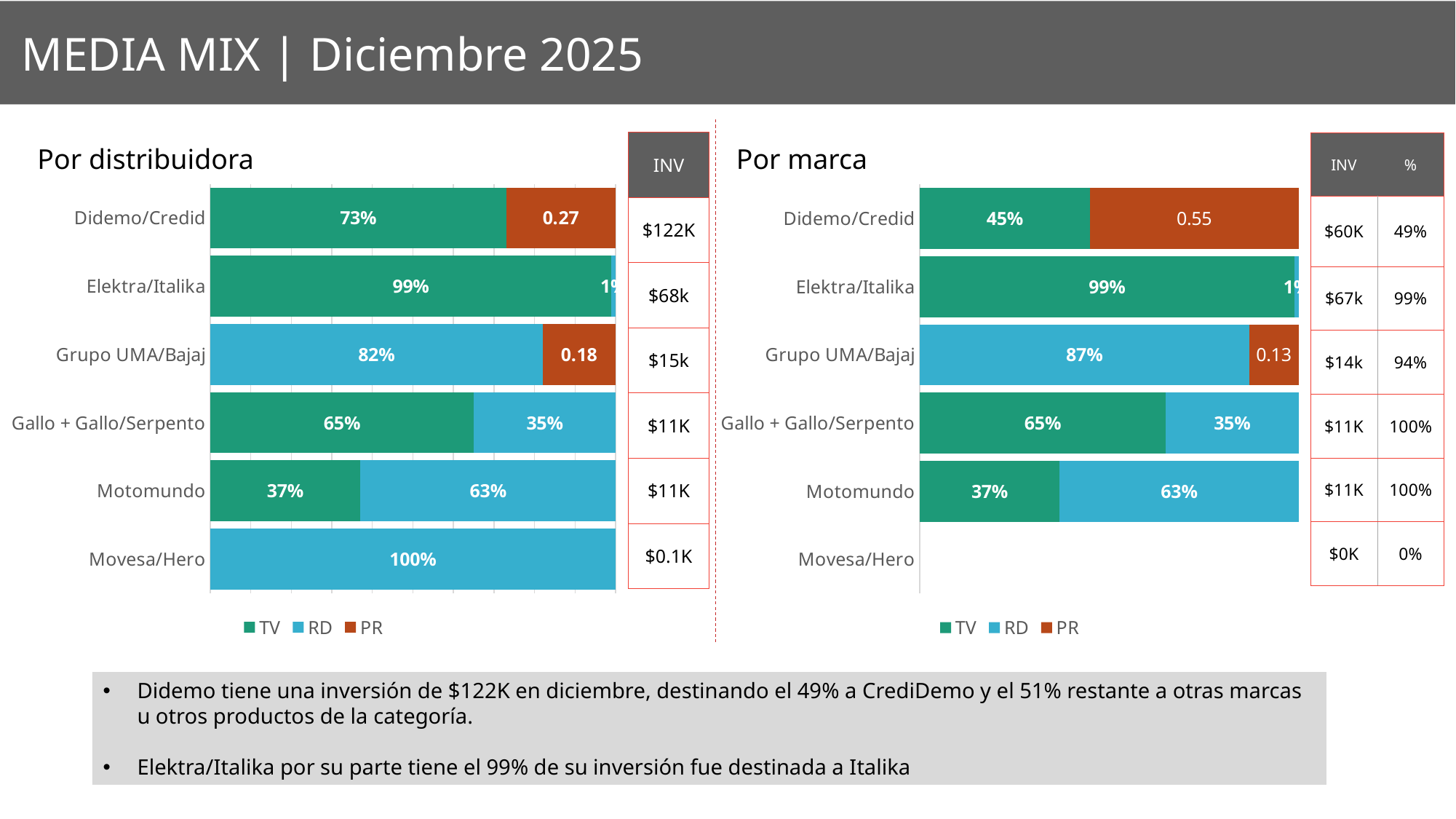
In the 'Por marca' chart, what is the PR value for Grupo UMA/Bajaj? 0.13 In the 'Por distribuidora' chart, what is the RD value for Grupo UMA/Bajaj? 82% In the 'Por marca' chart, which is larger for Gallo + Gallo/Serpento, the TV value or the RD value? TV How many categories are shown on the y axis of the 'Por marca' chart? 6 In the 'Por marca' chart, what is the TV value for Didemo/Credid? 45% In the 'Por distribuidora' chart, which category has the highest TV value? Elektra/Italika In the 'Por distribuidora' chart, what is the difference between the RD and TV values for Motomundo? 26% How many series does the legend of the 'Por distribuidora' chart list? 3 What kind of chart is the 'Por distribuidora' chart? Stacked bar chart In the 'Por marca' chart, what is the RD value for Gallo + Gallo/Serpento? 35% In the 'Por distribuidora' chart, what is the TV value for Didemo/Credid? 73% In the 'Por distribuidora' chart, what is the RD value for Motomundo? 63%